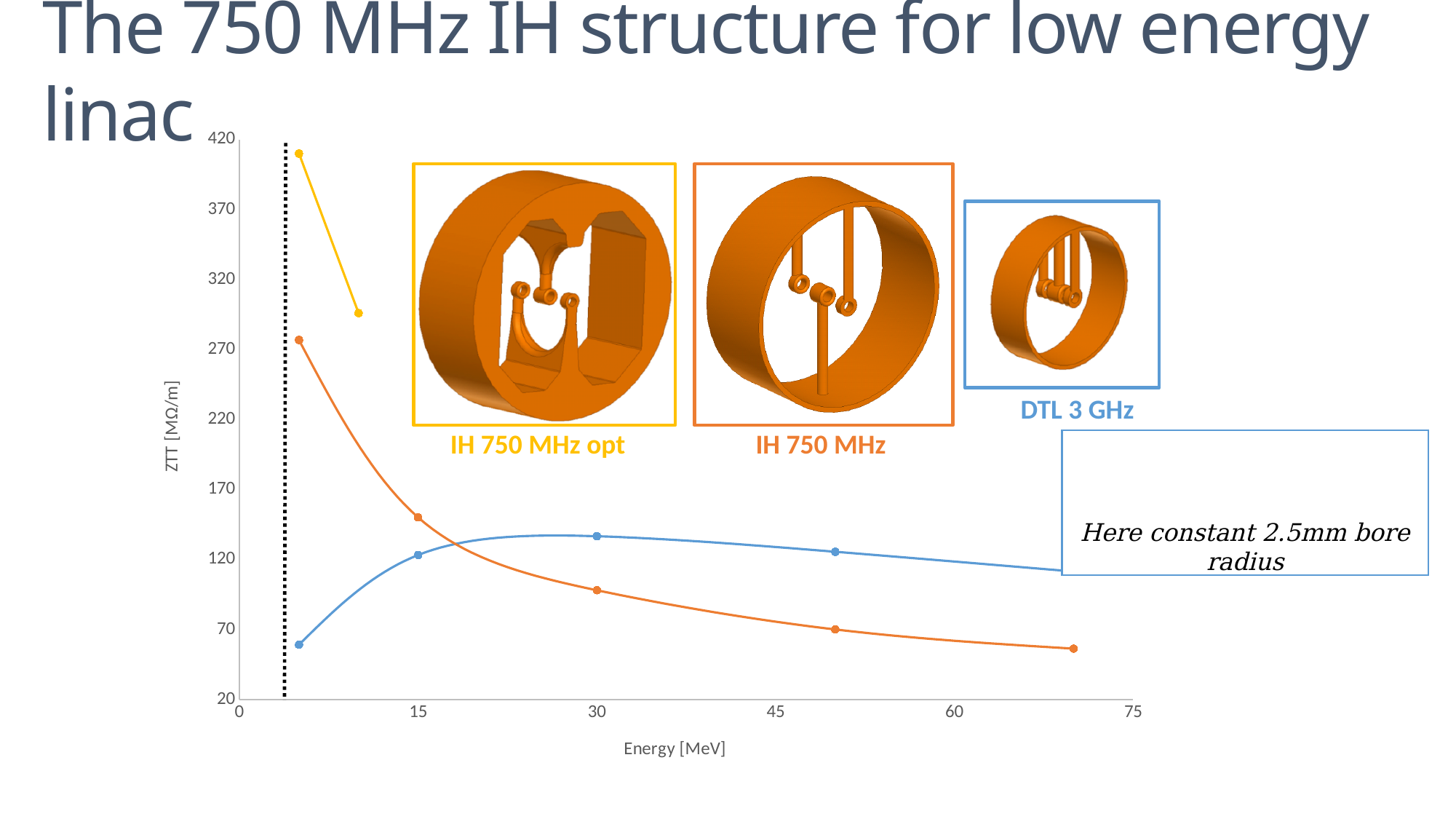
At 5 MeV, which series has the higher ZTT value: IH 750 MHz or DTL 3 GHz? IH 750 MHz How many data points does the IH 750 MHz opt (yellow) series have? 2 How many data points does the IH 750 MHz (orange) series have? 5 At 30 MeV, which series has the higher ZTT value: DTL 3 GHz or IH 750 MHz? DTL 3 GHz How many data series are plotted on the chart? 3 Is the value of the IH 750 MHz series at 30 MeV greater or less than 120? less What is the label of the x axis? Energy [MeV] Is the value of the IH 750 MHz series at 15 MeV greater or less than 170? less Does the IH 750 MHz series rise or fall as energy increases? fall Is the value of the DTL 3 GHz series at 30 MeV greater or less than 120? greater What kind of chart is shown on the slide? line chart